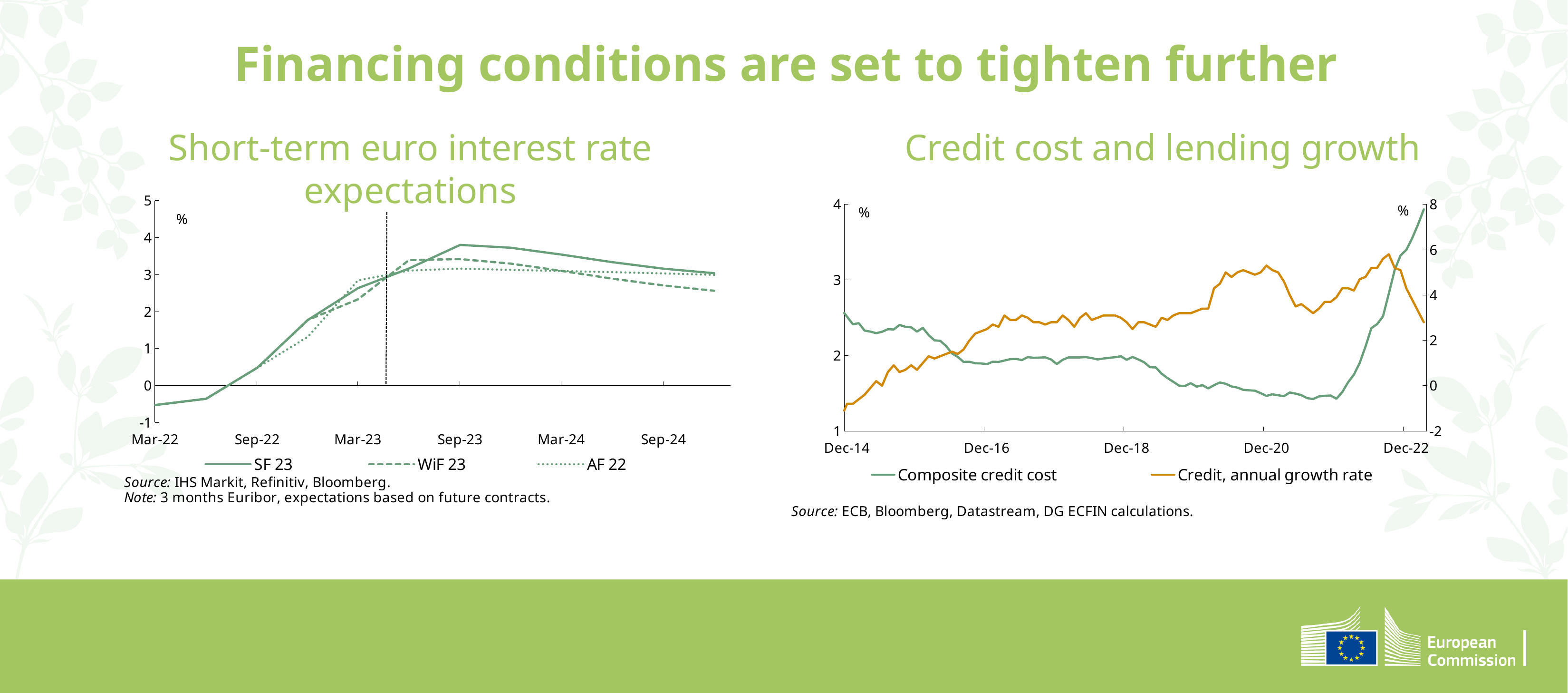
In the 'Short-term euro interest rate expectations' chart, which series is shown with a dotted line? AF 22 In the 'Short-term euro interest rate expectations' chart, which series has the highest value at Sep-23? SF 23 In the 'Short-term euro interest rate expectations' chart, does the SF 23 line rise or fall between Mar-22 and Sep-23? rise What kind of chart is the 'Credit cost and lending growth' chart? line chart In the 'Credit cost and lending growth' chart, does the Composite credit cost line rise or fall between Dec-20 and Dec-22? rise In the 'Credit cost and lending growth' chart, which series is drawn in orange? Credit, annual growth rate In the 'Credit cost and lending growth' chart, is the Composite credit cost at Dec-22 greater or less than 3? greater How many series does the legend of the 'Credit cost and lending growth' chart list? 2 In the 'Short-term euro interest rate expectations' chart, is the SF 23 value at Mar-22 greater or less than 0? less In the 'Short-term euro interest rate expectations' chart, is the SF 23 value at Sep-23 greater or less than 3? greater How many series does the legend of the 'Short-term euro interest rate expectations' chart list? 3 What kind of chart is the 'Short-term euro interest rate expectations' chart? line chart